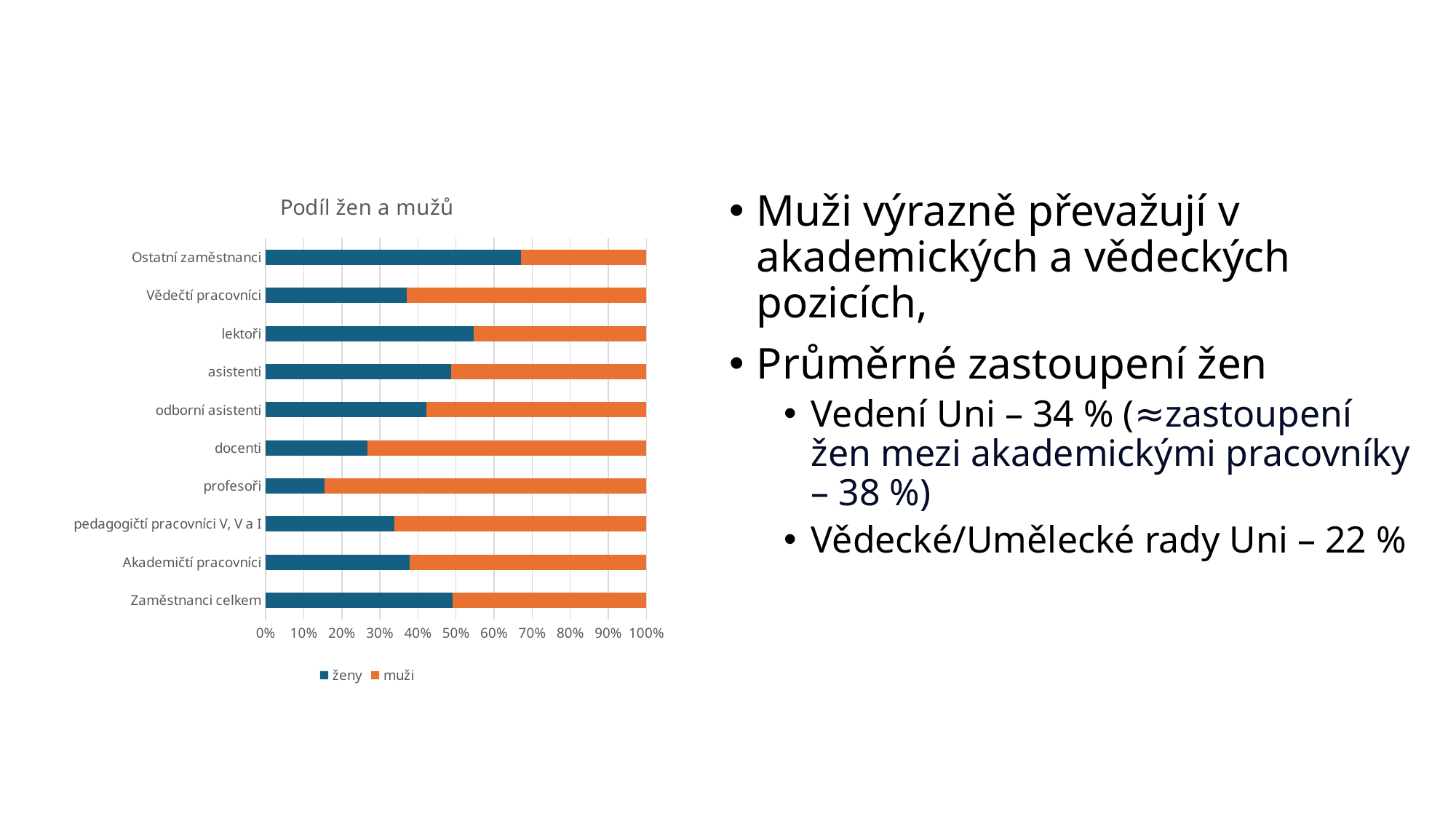
Which category has the highest share of ženy? Ostatní zaměstnanci What kind of chart is shown on the slide? stacked bar chart How many categories are shown on the chart's vertical axis? 10 How many series does the chart legend list? 2 Which category has the lowest share of ženy? profesoři What is the title of the chart? Podíl žen a mužů Is the share of ženy for profesoři greater or less than 20%? less Which category has a larger share of muži, profesoři or asistenti? profesoři Which category has a larger share of ženy, lektoři or docenti? lektoři Is the share of ženy for docenti greater or less than 30%? less Is the share of ženy for Ostatní zaměstnanci greater or less than 60%? greater Which colour represents the series muži in the chart? orange